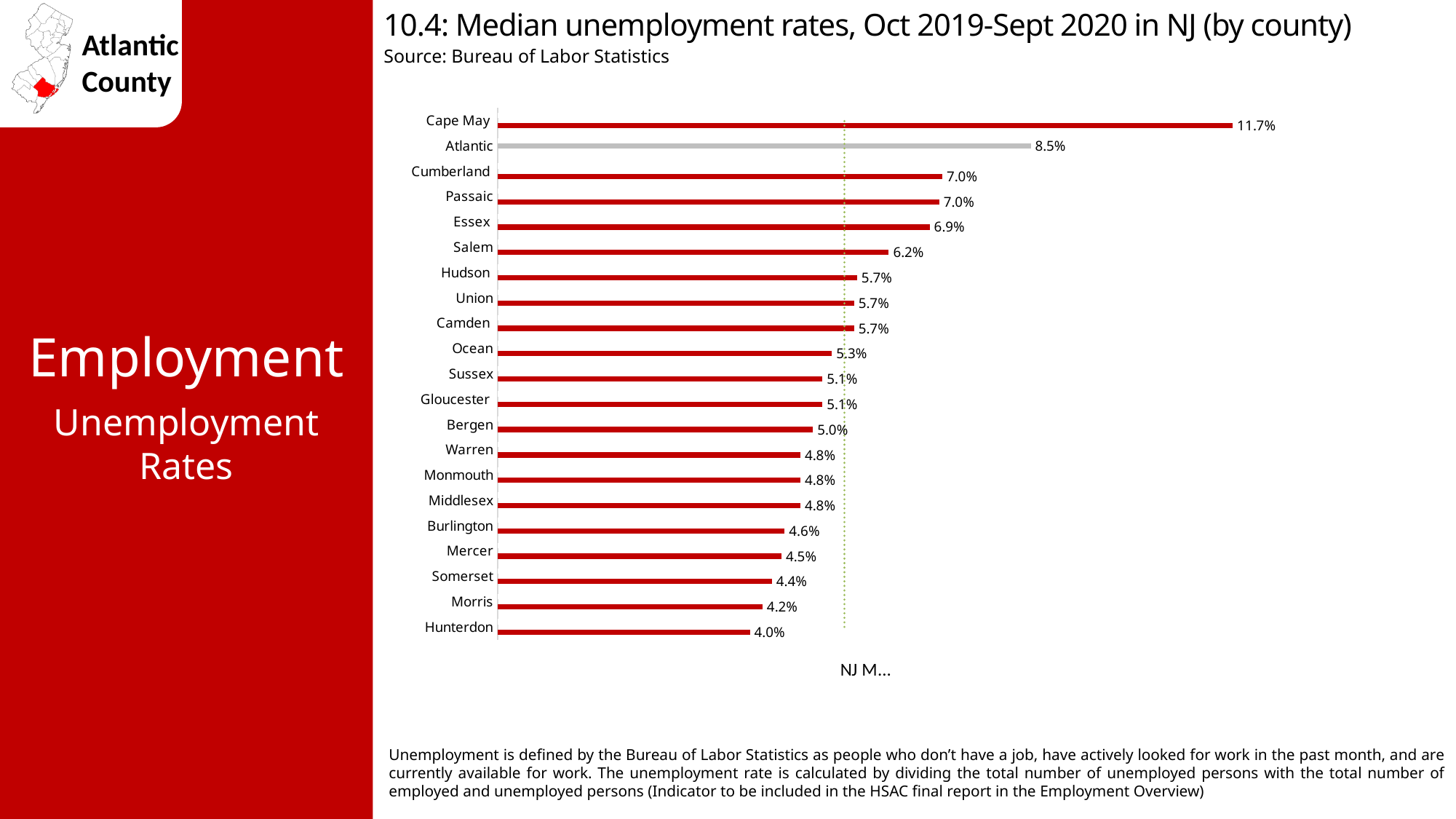
How many counties are shown in the chart? 21 What is the median unemployment rate for Cape May? 11.7% Which county has the lowest median unemployment rate? Hunterdon What is the median unemployment rate for Atlantic County? 8.5% Which county's bar is shown in grey rather than red? Atlantic What is the median unemployment rate for Hunterdon? 4.0% What is the difference between the median unemployment rates of Cape May and Atlantic? 3.2% What kind of chart is used on this slide? Bar chart Which county has a higher median unemployment rate, Salem or Ocean? Salem What is the difference between the median unemployment rates of Atlantic and Hunterdon? 4.5% Which county has the highest median unemployment rate? Cape May What is the median unemployment rate for Essex? 6.9%